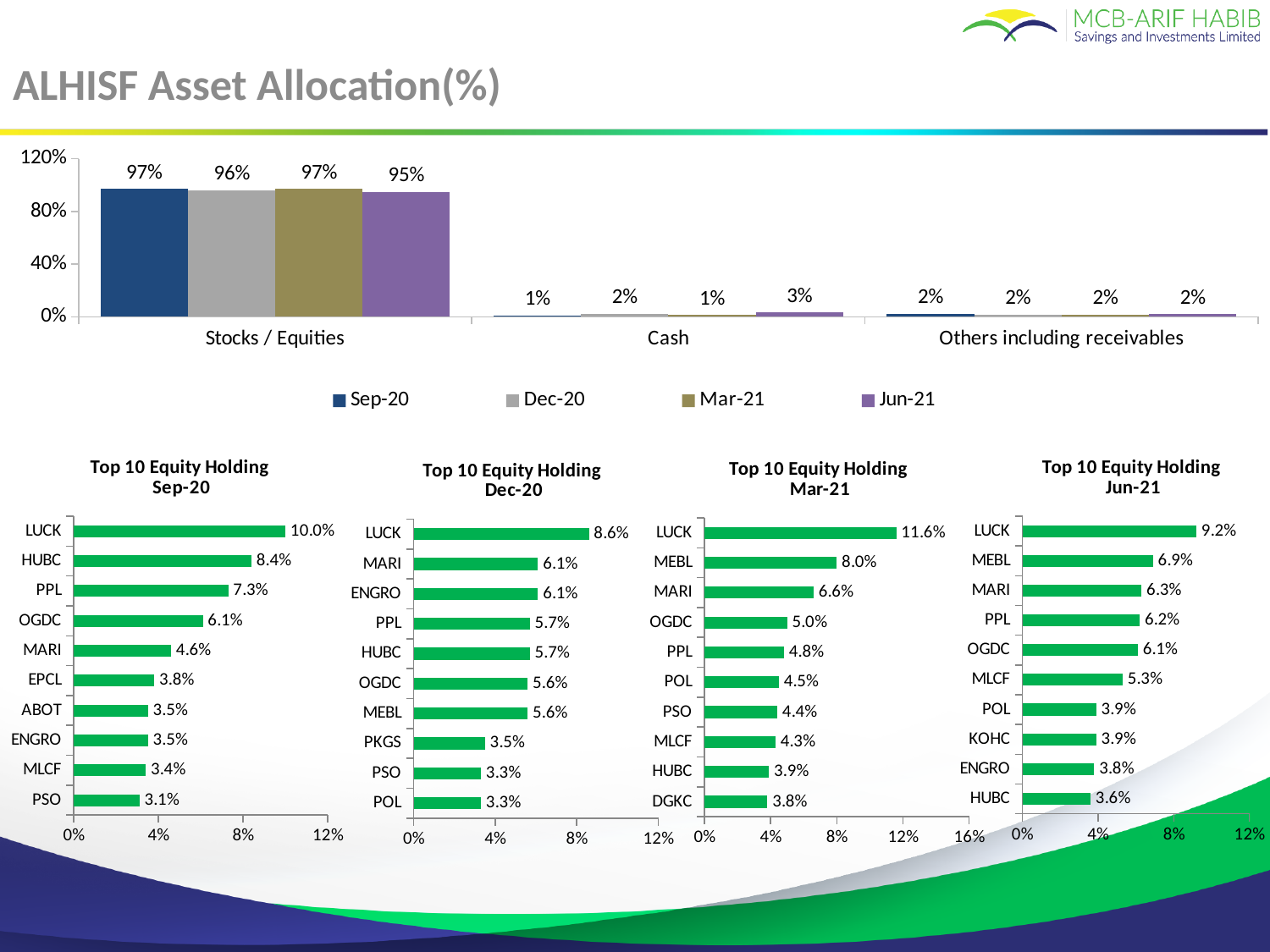
In the asset allocation chart at the top of the slide, what is the value for Stocks / Equities in Jun-21? 95% In the 'Top 10 Equity Holding Mar-21' chart, which holding has the highest value? LUCK In the 'Top 10 Equity Holding Sep-20' chart, what is the value for HUBC? 8.4% In the 'Top 10 Equity Holding Mar-21' chart, which is larger, MEBL or OGDC? MEBL How many series does the legend of the asset allocation chart at the top of the slide list? 4 In the asset allocation chart at the top of the slide, what is the difference between the Stocks / Equities values for Sep-20 and Jun-21? 2% In the asset allocation chart at the top of the slide, what is the value for Cash in Jun-21? 3% What kind of chart is the 'Top 10 Equity Holding Jun-21' chart? Bar chart In the 'Top 10 Equity Holding Sep-20' chart, which holding has the lowest value? PSO In the 'Top 10 Equity Holding Jun-21' chart, what is the value for MLCF? 5.3% In the 'Top 10 Equity Holding Dec-20' chart, what is the difference between LUCK and MARI? 2.5% In the 'Top 10 Equity Holding Dec-20' chart, what is the value for LUCK? 8.6%